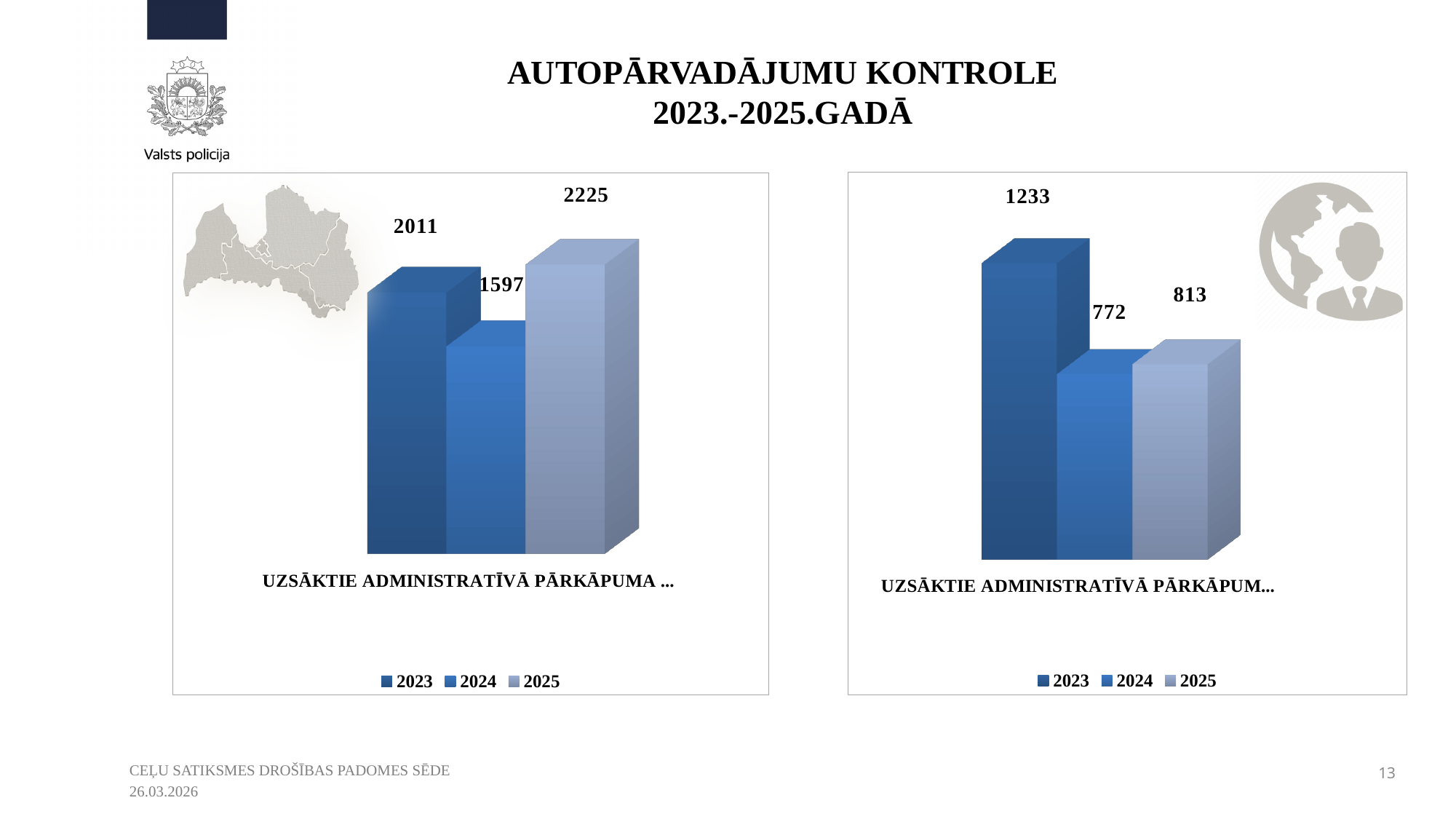
In the left chart, what is the value for 2025? 2225 In the right chart, which year has the highest value? 2023 In the right chart, what is the value for 2023? 1233 How many series does the legend of the left chart list? 3 In the right chart, what is the difference between the 2023 and 2025 values? 420 In the right chart, what is the value for 2024? 772 What kind of chart is the right chart? bar chart In the left chart, what is the difference between the 2025 and 2024 values? 628 Which years are listed in the legend of the right chart? 2023, 2024, 2025 In the left chart, which year has the lowest value? 2024 In the left chart, what is the value for 2023? 2011 In the right chart, which is larger, the value for 2024 or the value for 2025? 2025